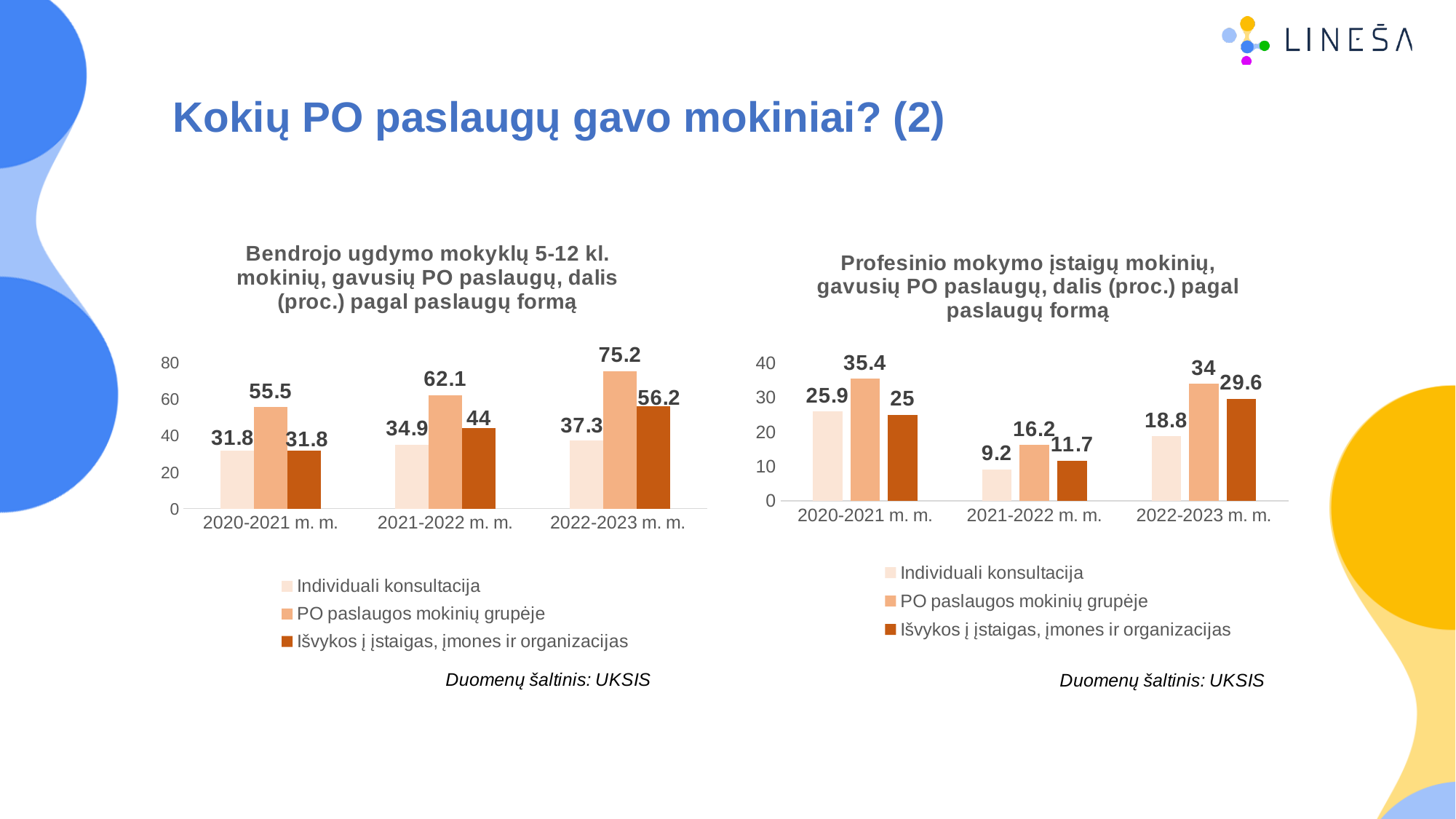
How many series does the legend of the left chart (Bendrojo ugdymo mokyklų 5-12 kl.) list? 3 In the left chart (Bendrojo ugdymo mokyklų 5-12 kl.), what is the value for PO paslaugos mokinių grupėje in 2022-2023 m. m.? 75.2 In the right chart (Profesinio mokymo įstaigų mokinių), what is the value for PO paslaugos mokinių grupėje in 2022-2023 m. m.? 34 In the right chart (Profesinio mokymo įstaigų mokinių), what is the difference between Individuali konsultacija in 2020-2021 m. m. and in 2021-2022 m. m.? 16.7 In the left chart (Bendrojo ugdymo mokyklų 5-12 kl.), does the value for Individuali konsultacija rise or fall from 2020-2021 m. m. to 2022-2023 m. m.? Rise In the right chart (Profesinio mokymo įstaigų mokinių), what is the value for Individuali konsultacija in 2021-2022 m. m.? 9.2 In the left chart (Bendrojo ugdymo mokyklų 5-12 kl.), which school year has the highest value for PO paslaugos mokinių grupėje? 2022-2023 m. m. In the left chart (Bendrojo ugdymo mokyklų 5-12 kl.), what is the difference between PO paslaugos mokinių grupėje and Individuali konsultacija in 2022-2023 m. m.? 37.9 In the left chart (Bendrojo ugdymo mokyklų 5-12 kl.), what is the value for Išvykos į įstaigas, įmones ir organizacijas in 2021-2022 m. m.? 44 What kind of chart is the right chart (Profesinio mokymo įstaigų mokinių)? Bar chart In the right chart (Profesinio mokymo įstaigų mokinių), which is larger in 2020-2021 m. m.: Individuali konsultacija or Išvykos į įstaigas, įmones ir organizacijas? Individuali konsultacija In the right chart (Profesinio mokymo įstaigų mokinių), which school year has the lowest value for Išvykos į įstaigas, įmones ir organizacijas? 2021-2022 m. m.